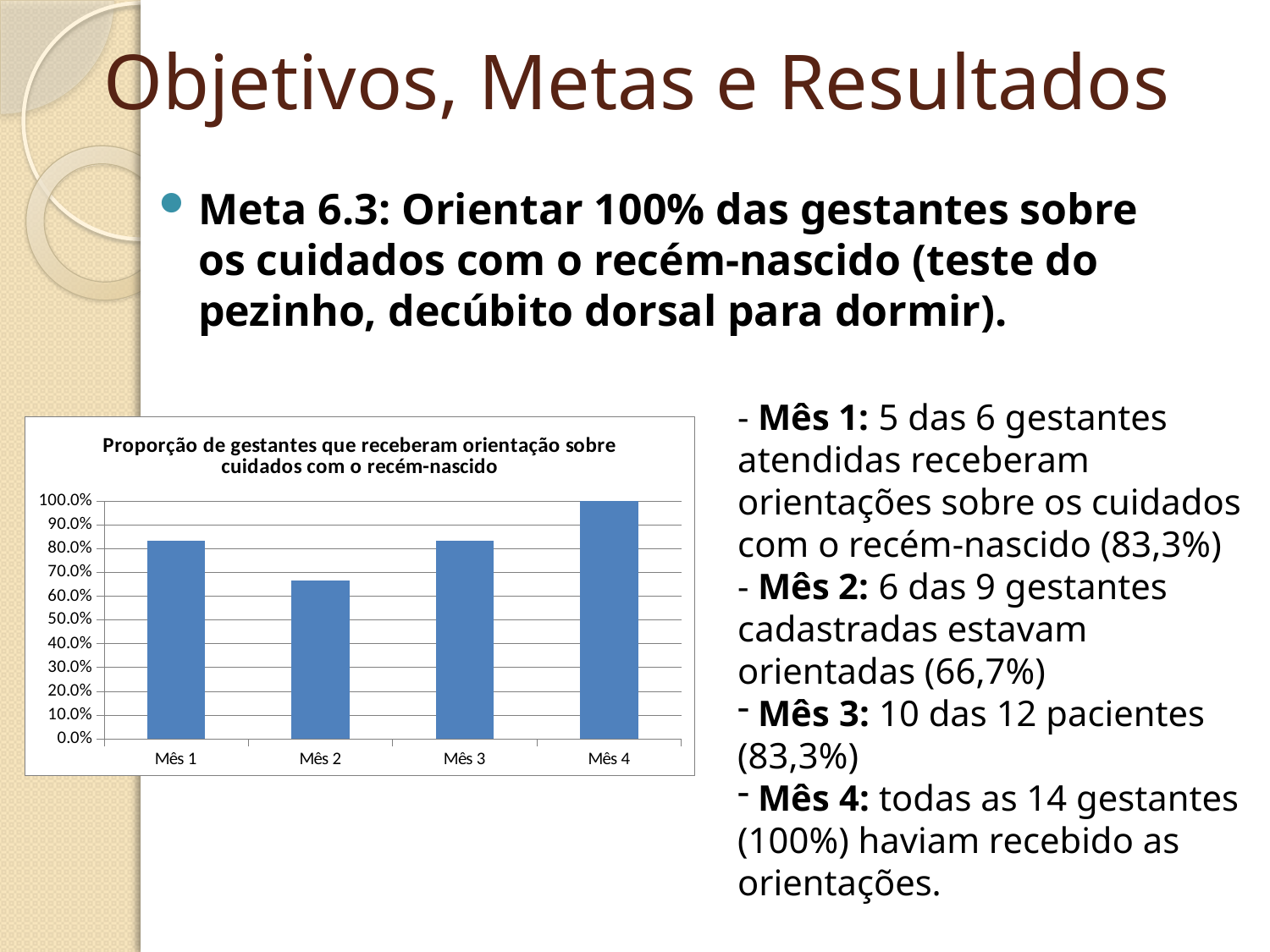
Is the value for Mês 3 greater or less than 90.0%? less Do the values rise or fall from Mês 2 to Mês 4? rise What is the title of the chart? Proporção de gestantes que receberam orientação sobre cuidados com o recém-nascido What type of chart is shown on the slide? bar chart Is the value for Mês 2 greater or less than 70.0%? less Which is larger, the value for Mês 2 or the value for Mês 4? Mês 4 Which month has the lowest proportion in the chart? Mês 2 Which month has the highest proportion in the chart? Mês 4 Is the value for Mês 1 greater or less than 80.0%? greater What colour are the bars in the chart? blue What is the value for Mês 4 in the chart? 100.0% How many categories (months) are shown on the x axis of the chart? 4